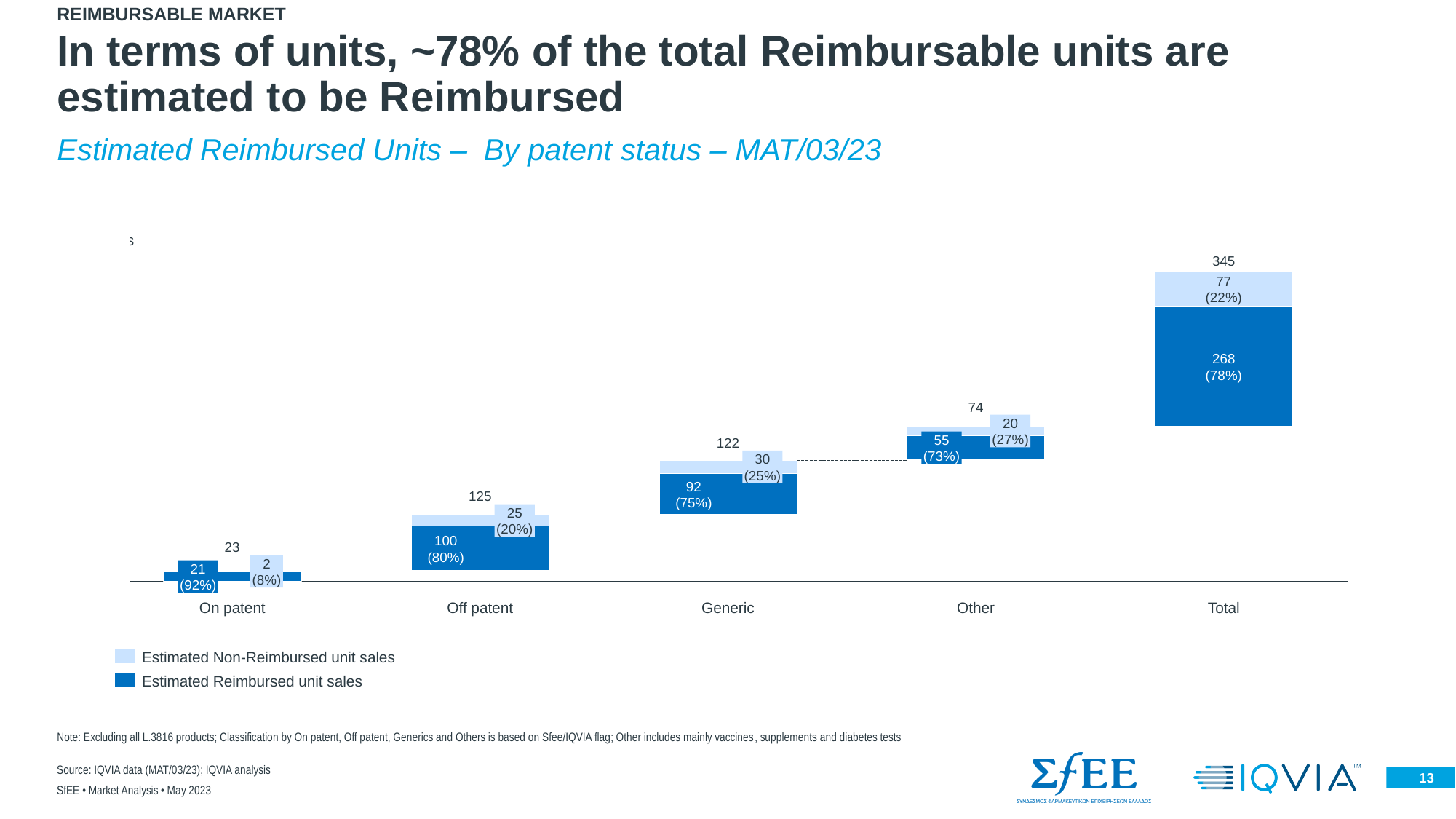
What percentage of the Total bar is Estimated Reimbursed unit sales? 78% What kind of chart is shown on the slide? Bar chart What is the difference between the Estimated Reimbursed unit sales for Off patent and for Generic? 8 What is the total value shown for the Off patent category? 125 Which category has the lowest total value? On patent What is the total value of the Total bar? 345 Which is larger: the Estimated Non-Reimbursed unit sales for Generic or for Off patent? Generic How many categories are shown on the x axis? 5 Excluding the Total bar, which category has the highest total value? Off patent How many series does the legend list? 2 What is the Estimated Reimbursed unit sales value for Generic? 92 What is the Estimated Non-Reimbursed unit sales value for Other? 20